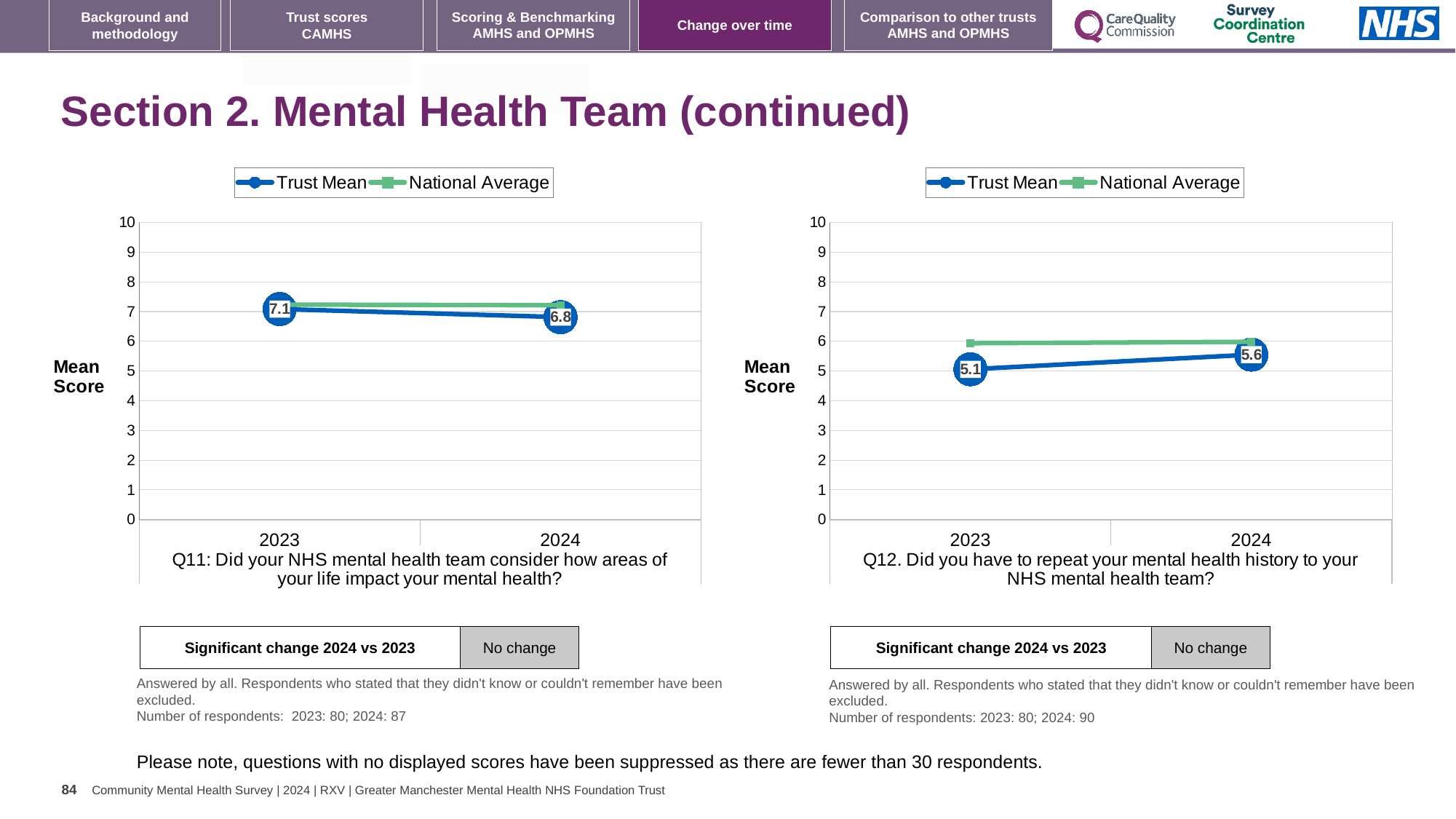
In the Q11 chart on the left, what is the Trust Mean for 2023? 7.1 What kind of chart is the Q12 chart on the right? line chart In the Q12 chart on the right, does the Trust Mean rise or fall from 2023 to 2024? rise In the Q12 chart on the right, what is the Trust Mean for 2024? 5.6 In the Q11 chart on the left, what is the Trust Mean for 2024? 6.8 In the Q12 chart on the right, which is larger in 2023, the Trust Mean or the National Average? National Average In the Q12 chart on the right, what is the difference between the Trust Mean for 2024 and 2023? 0.5 In the Q12 chart on the right, is the National Average for 2023 greater or less than 5? greater In the Q12 chart on the right, what is the Trust Mean for 2023? 5.1 In the Q11 chart on the left, by how much did the Trust Mean change from 2023 to 2024? 0.3 In the Q11 chart on the left, does the Trust Mean rise or fall from 2023 to 2024? fall How many series does the legend of the Q11 chart on the left list? 2